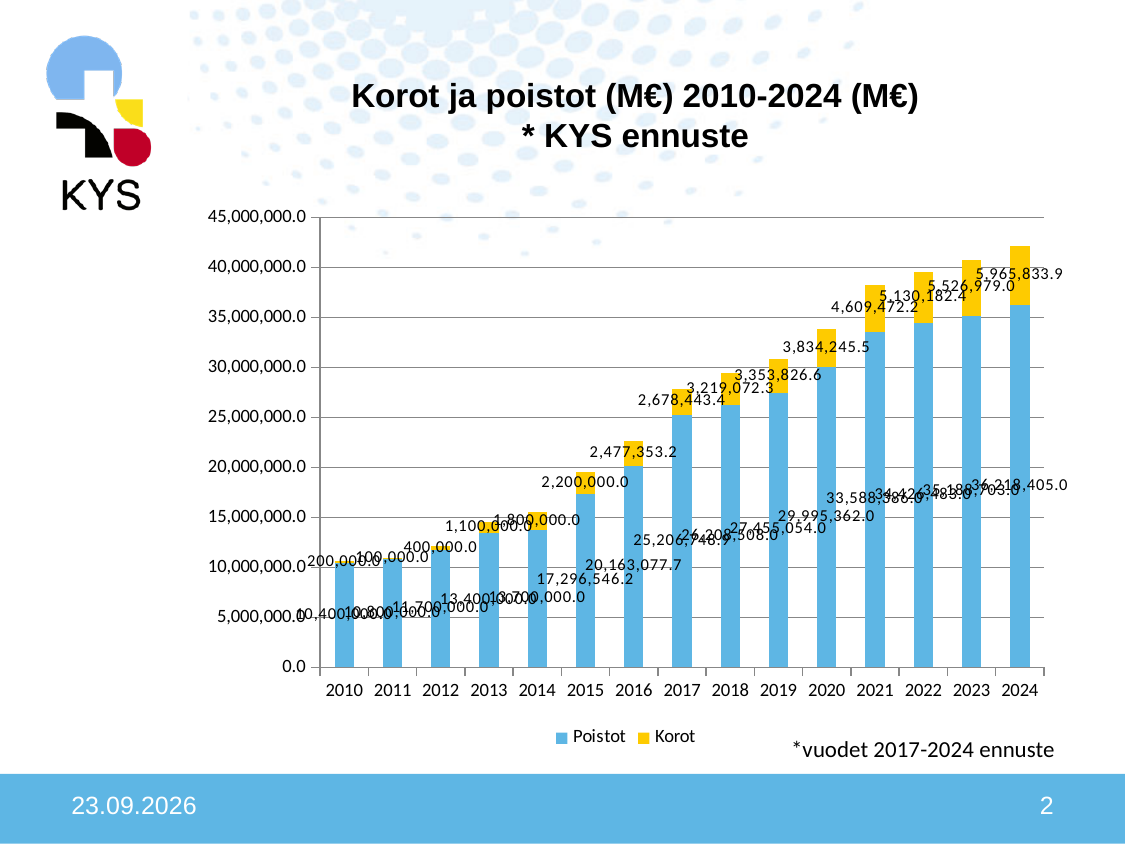
What kind of chart is shown on the slide? Stacked bar chart What is the Korot value for 2024? 5,965,833.9 What is the total of the stacked bar for 2024 (Poistot plus Korot)? 42,184,238.9 What is the Poistot value for 2020? 29,995,362.0 How many series does the legend list? 2 Is the Poistot value for 2010 greater or less than 15,000,000.0? less How many years are shown on the x axis of the chart? 15 Do the total bar heights rise or fall from 2010 to 2024? Rise What is the Poistot value for 2015? 17,296,546.2 What is the Korot value for 2016? 2,477,353.2 In which year is the Korot value highest? 2024 What is the difference between the Korot values for 2024 and 2023? 438,854.9